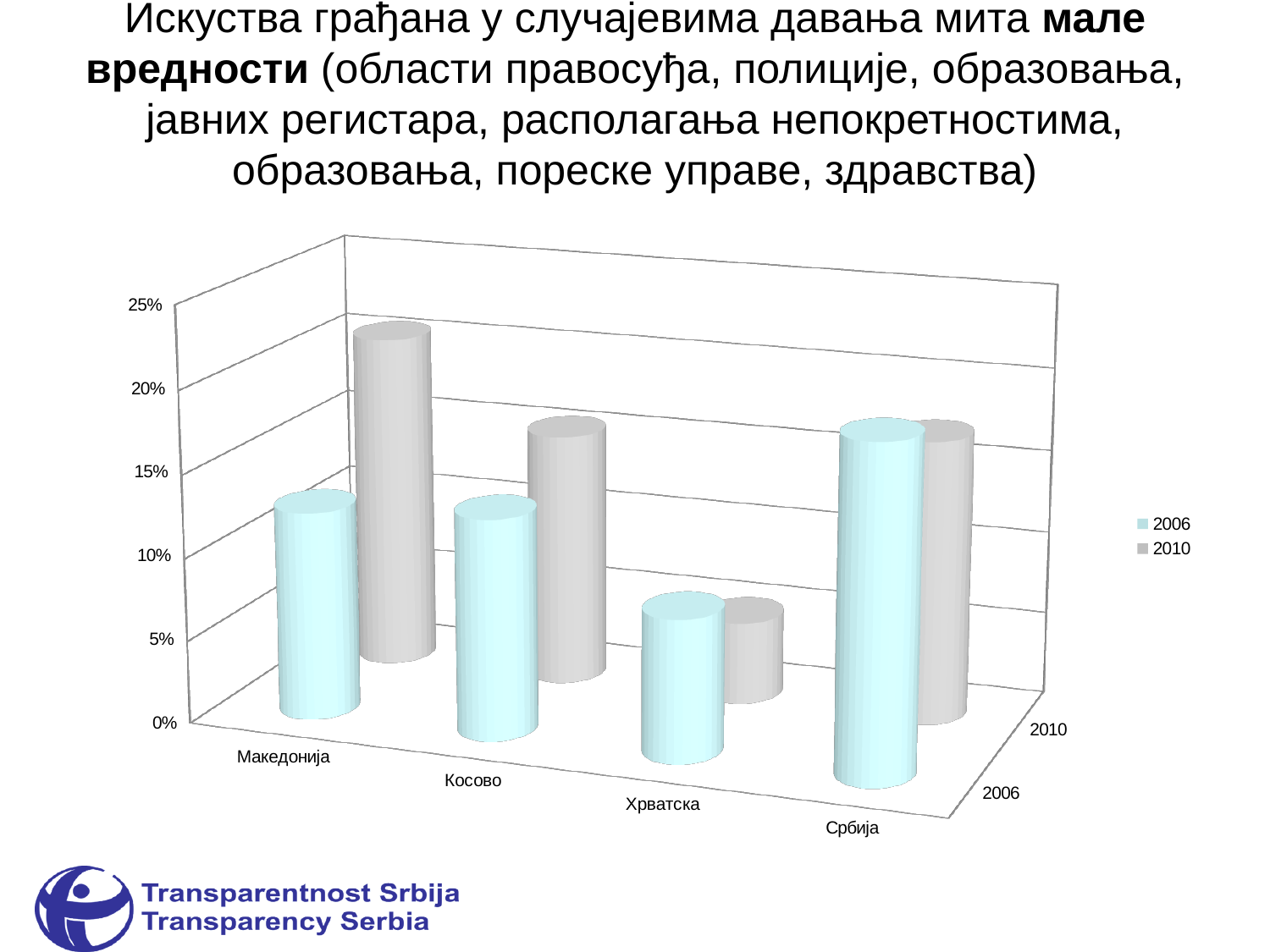
How many countries are shown on the x axis of the chart? 4 Which country has the lowest value in the 2010 series? Хрватска Which country has the lowest value in the 2006 series? Хрватска What are the two series named in the chart legend? 2006 and 2010 What kind of chart is shown on the slide? bar chart In the 2006 series, which is larger, the value for Србија or the value for Хрватска? Србија For Косово, which series has the larger value, 2006 or 2010? 2010 Which country has the highest value in the 2010 series? Македонија For Македонија, which series has the larger value, 2006 or 2010? 2010 How many series does the chart legend list? 2 Is the 2010 value for Македонија greater or less than 15%? greater Is the 2006 value for Хрватска greater or less than 10%? less